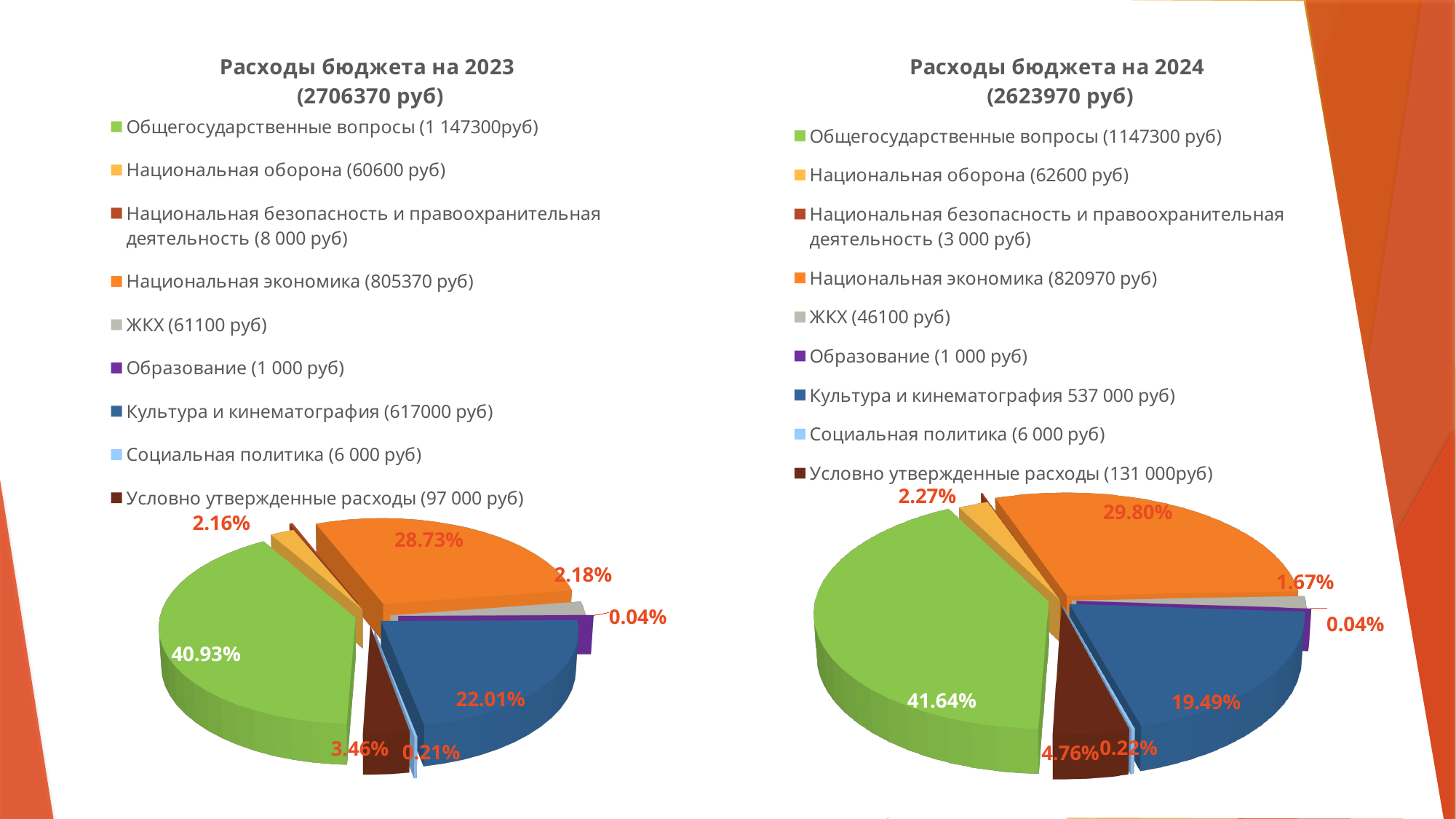
Which is larger: the share of Национальная экономика in the 2023 chart or in the 2024 chart? 2024 (29.80%) What is the difference between the Общегосударственные вопросы share in the 2024 chart (41.64%) and in the 2023 chart (40.93%)? 0.71% In the 'Расходы бюджета на 2023' chart, what share is shown for Национальная экономика (the orange slice)? 28.73% In the 'Расходы бюджета на 2023' chart, what share is shown for the largest slice (Общегосударственные вопросы)? 40.93% What total budget amount is shown in the title of the 'Расходы бюджета на 2023' chart? 2706370 руб What kind of chart is used for 'Расходы бюджета на 2023'? pie chart In the 'Расходы бюджета на 2023' chart, which category has the smallest labelled share (0.04%)? Образование How many categories does the legend of the 'Расходы бюджета на 2024' chart list? 9 In the 'Расходы бюджета на 2024' chart, what share is shown for Культура и кинематография (the blue slice)? 19.49% According to the legend, what is the amount for Национальная экономика in the 'Расходы бюджета на 2024' chart? 820970 руб In the 'Расходы бюджета на 2024' chart, what share is shown for Общегосударственные вопросы? 41.64% In the 'Расходы бюджета на 2024' chart, which category has the largest slice? Общегосударственные вопросы